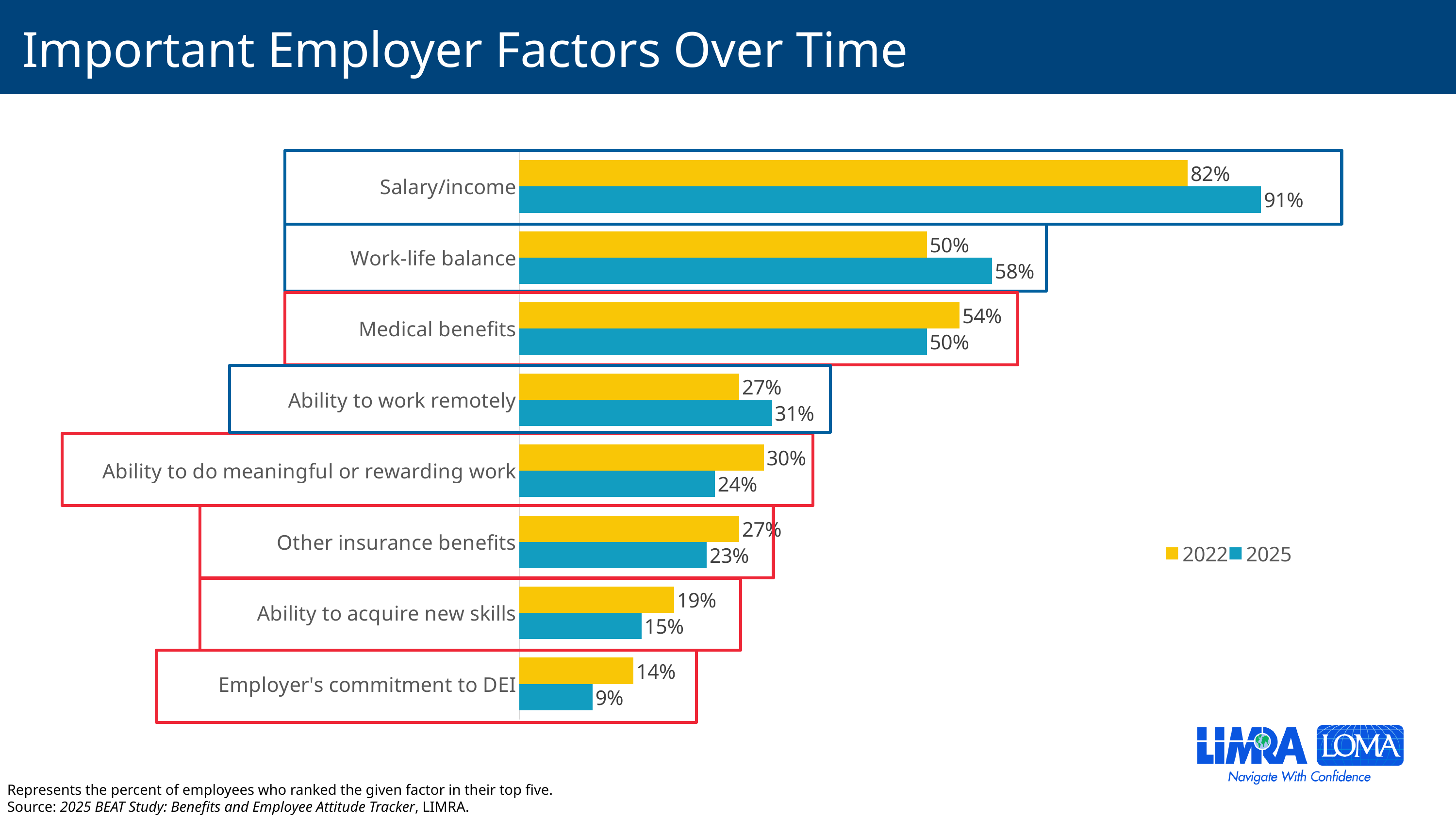
What is the 2022 value for Medical benefits? 54% What is the 2025 value for Salary/income? 91% How many factors are shown on the chart? 8 What kind of chart is shown on the slide? Bar chart What is the difference between the 2025 and 2022 values for Work-life balance? 8% Which is larger for Ability to work remotely, the 2022 value or the 2025 value? 2025 What is the 2025 value for Employer's commitment to DEI? 9% What is the difference between the 2022 and 2025 values for Ability to do meaningful or rewarding work? 6% Which factor has the highest 2025 value? Salary/income Which factor has the lowest 2022 value? Employer's commitment to DEI Which colour represents the 2022 series? Yellow How many series does the legend list? 2